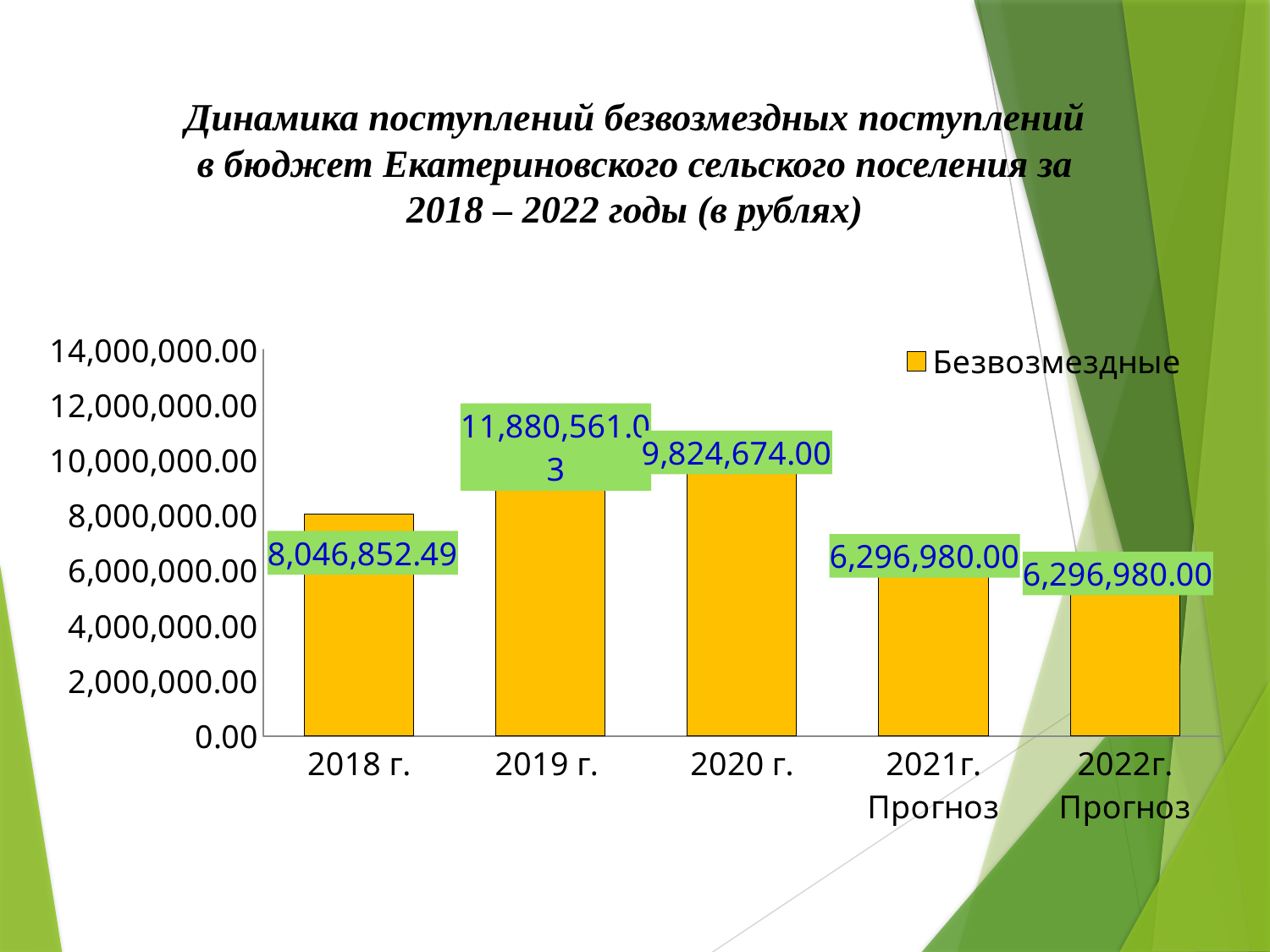
How many categories are shown on the x axis? 5 Is the value for 2021г. Прогноз greater or less than 8,000,000.00? less What is the difference between the values for 2019 г. and 2020 г.? 2,055,887.03 What kind of chart is shown on the slide? bar chart What is the difference between the values for 2020 г. and 2018 г.? 1,777,821.51 What is the value for 2021г. Прогноз? 6,296,980.00 Which is larger, the value for 2019 г. or 2020 г.? 2019 г. Which year has the highest value? 2019 г. How many series does the legend list? 1 What is the value for 2019 г.? 11,880,561.03 What is the value for 2018 г.? 8,046,852.49 What is the value for 2020 г.? 9,824,674.00